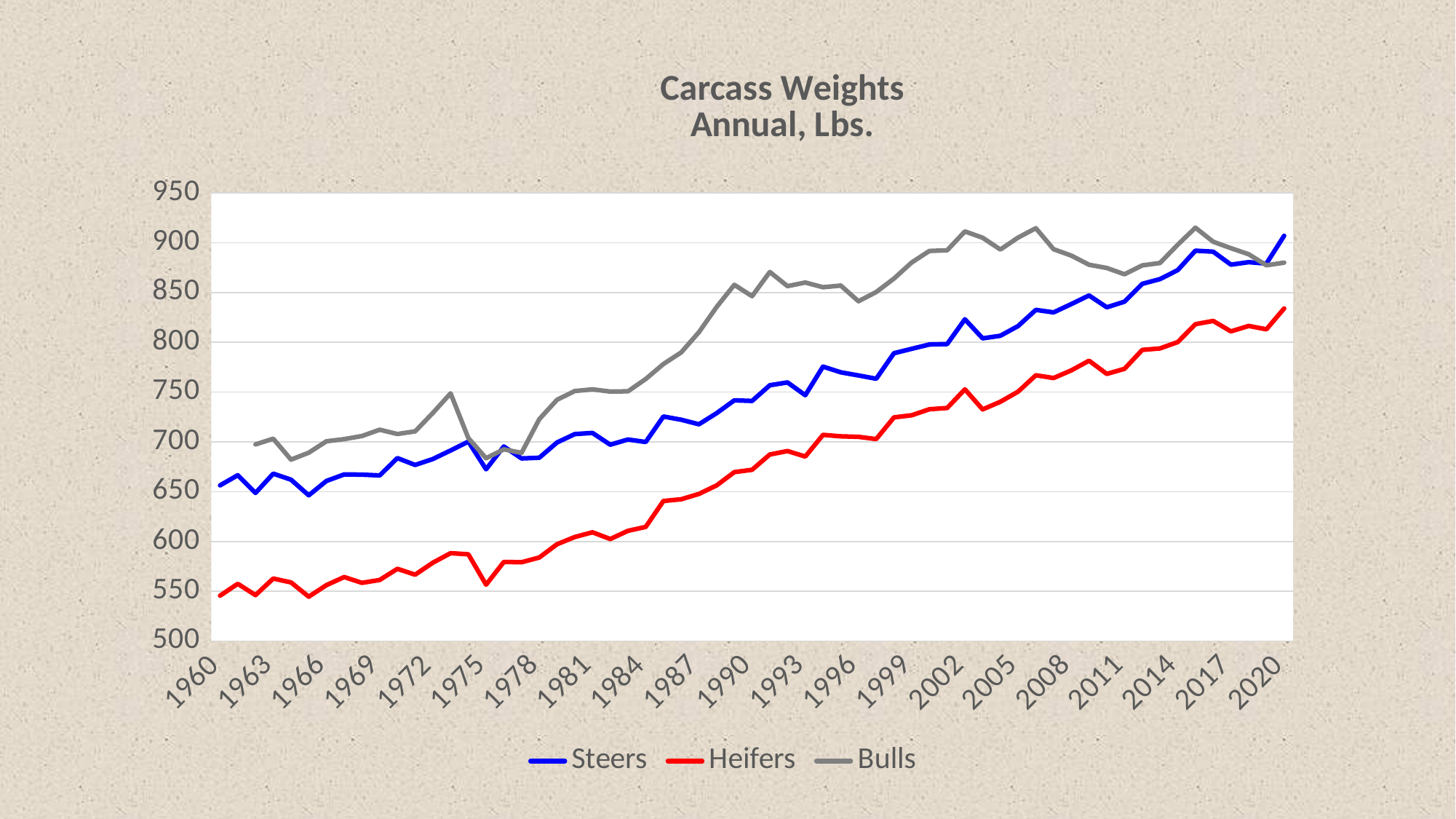
Which series is drawn in red? Heifers Which series has the lowest values across the whole period? Heifers Is the value for Bulls in 1990 greater or less than 800? greater Is the value for Steers in 2020 greater or less than 850? greater Which series has the highest value in 1990? Bulls Is the value for Heifers in 1975 greater or less than 600? less In 2020, which is larger, the value for Steers or the value for Heifers? Steers What kind of chart is shown on the slide? line chart Do the Heifers values generally rise or fall from 1960 to 2020? rise What is the title of the chart? Carcass Weights Annual, Lbs. How many series does the legend list? 3